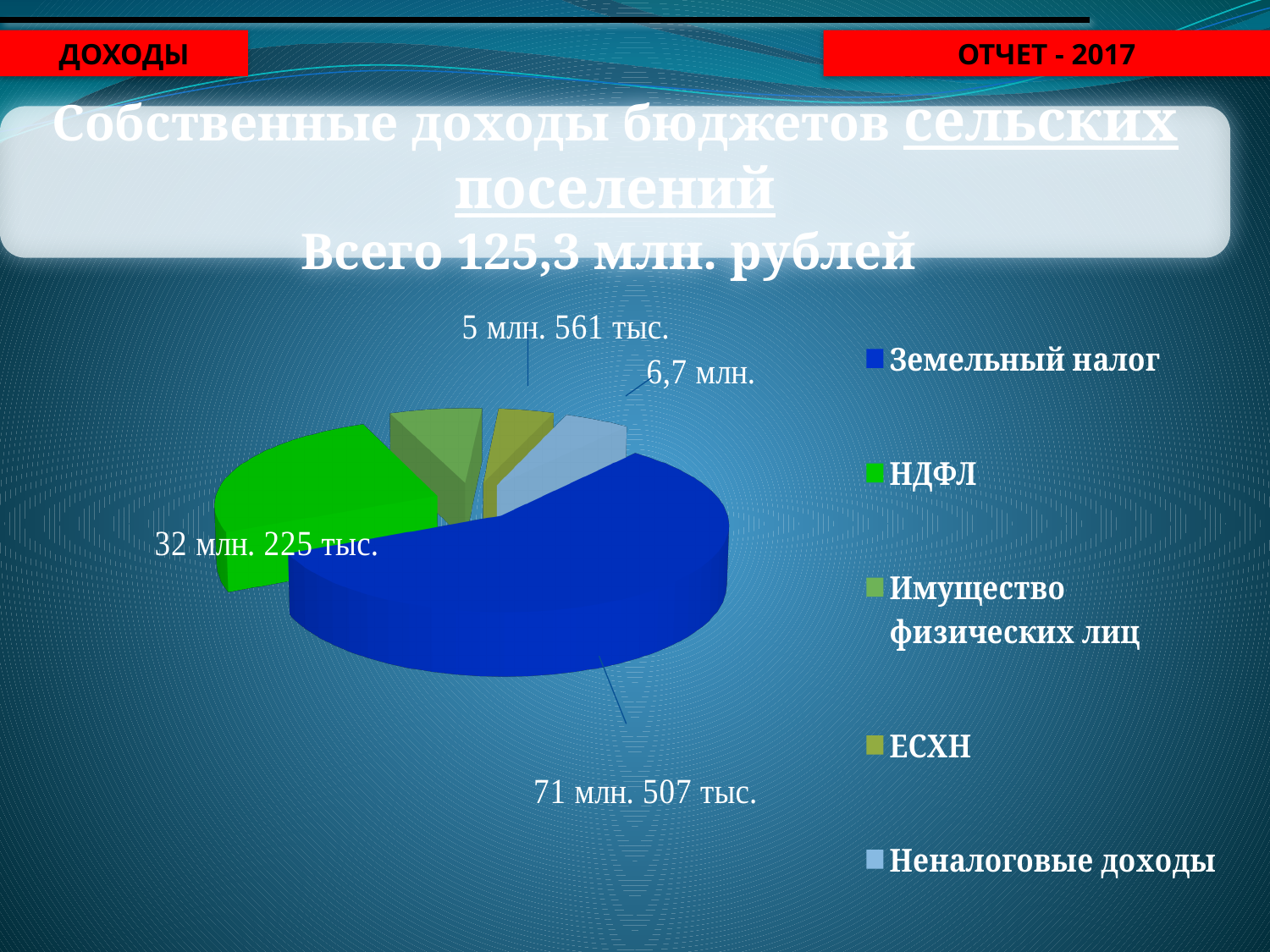
What value is shown for НДФЛ? 32 млн. 225 тыс. What value is shown for Земельный налог? 71 млн. 507 тыс. What total amount is stated in the chart title? 125,3 млн. рублей What value is shown for Неналоговые доходы? 6,7 млн. What is the difference between Земельный налог and НДФЛ? 39 млн. 282 тыс. Which is larger, Земельный налог or НДФЛ? Земельный налог What kind of chart is shown on the slide? pie chart What colour is the slice for Земельный налог? blue How many categories does the legend of the pie chart list? 5 Which category has the largest slice of the pie? Земельный налог